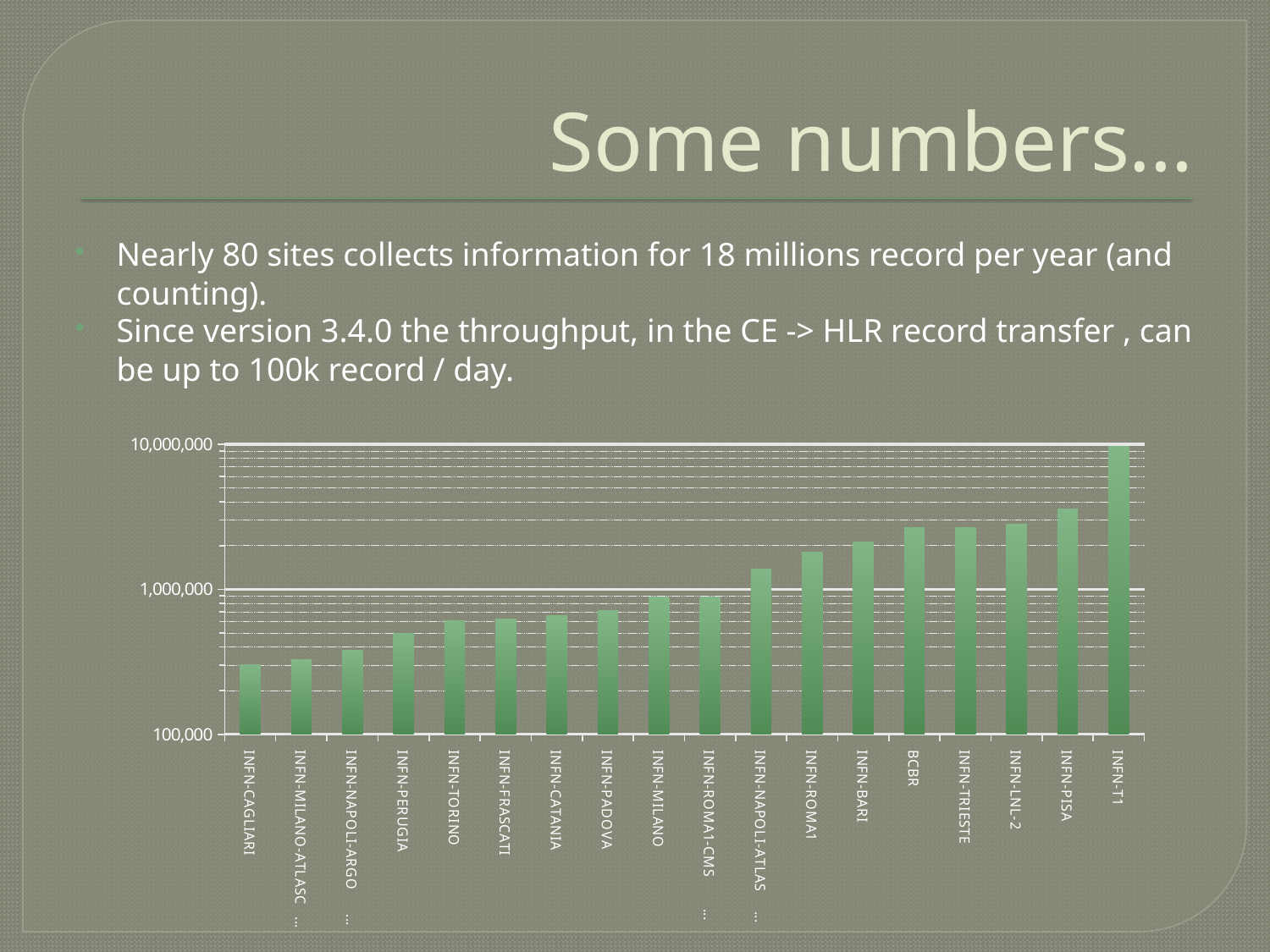
Which site has the highest value in the chart? INFN-T1 Which has the larger value, INFN-BARI or INFN-CATANIA? INFN-BARI What is the highest tick value shown on the y axis of the chart? 10,000,000 How many sites (bars) are shown in the chart? 18 Is the value for INFN-T1 greater or less than 1,000,000? greater Is the value for INFN-CAGLIARI greater or less than 1,000,000? less Which site has the lowest value in the chart? INFN-CAGLIARI Is the value for INFN-ROMA1 greater or less than 1,000,000? greater Do the bar values rise or fall from left to right along the x axis? rise What kind of chart is shown on the slide? bar chart Which has the larger value, INFN-PISA or INFN-PERUGIA? INFN-PISA